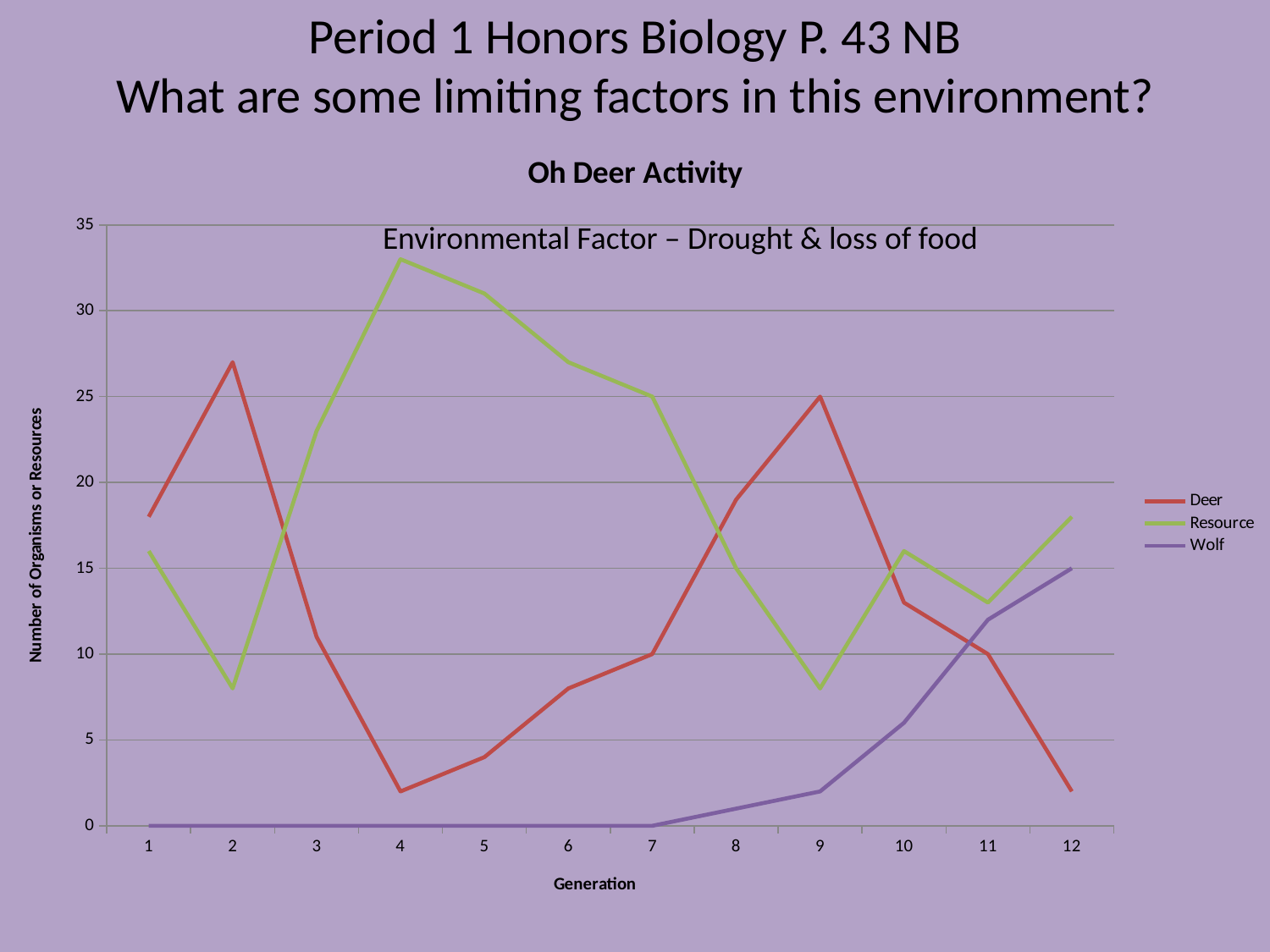
What kind of chart is shown on the slide? Line chart Is the Deer value at generation 4 greater or less than 5? less How many series does the legend list? 3 Does the Wolf series rise or fall from generation 7 to generation 12? Rise Is the Resource value at generation 4 greater or less than 30? greater How many generations are plotted along the x axis? 12 What is the Wolf value at generation 1? 0 At which generation does the Resource series reach its highest value? 4 What is the Deer value at generation 9? 25 At generation 4, which is larger, the Deer value or the Resource value? Resource At which generation does the Deer series reach its highest value? 2 What is the Deer value at generation 7? 10